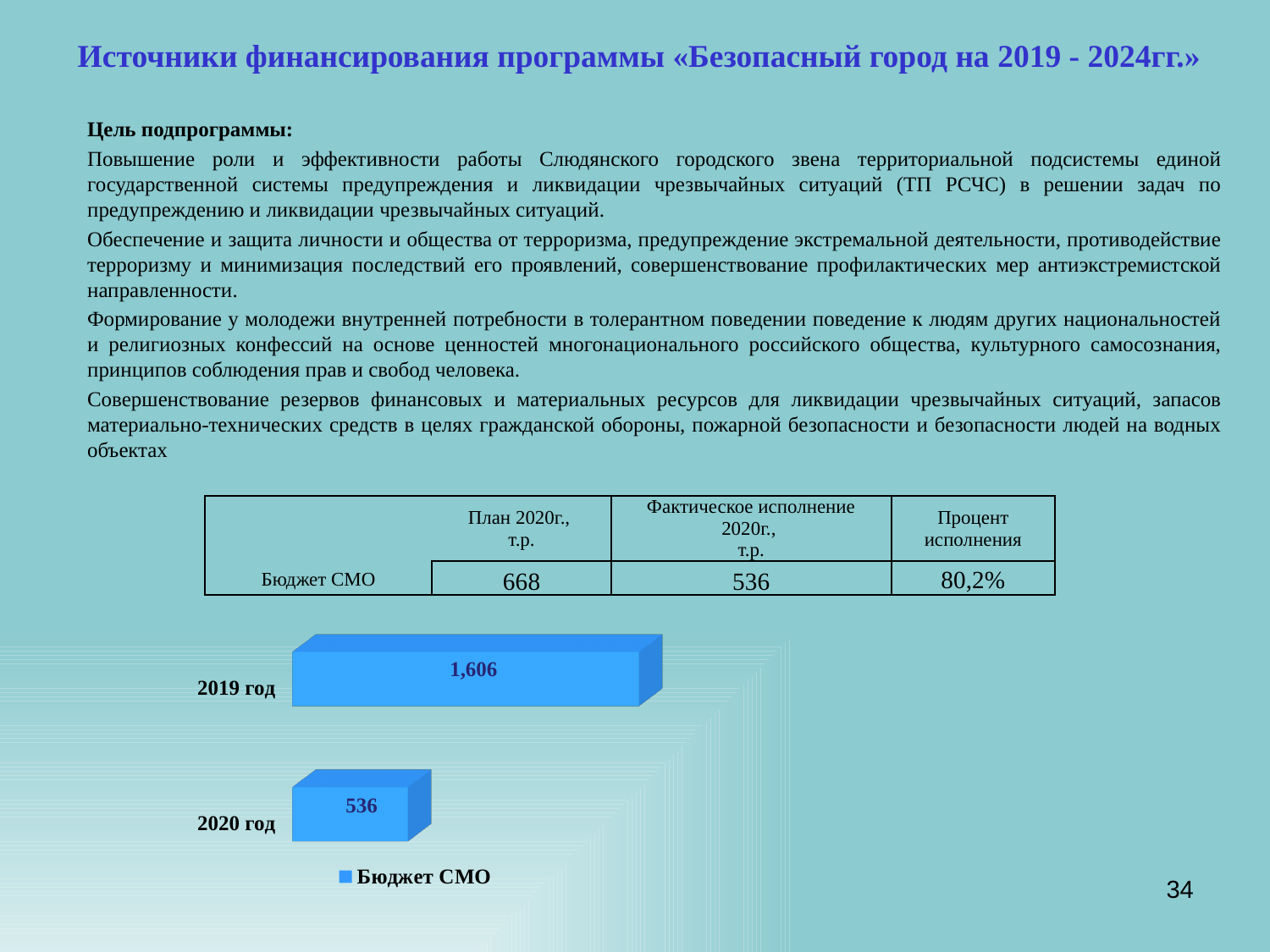
What series name is shown in the chart legend? Бюджет СМО Are the bars in the chart oriented horizontally or vertically? Horizontally What kind of chart is shown on the slide? Bar chart How many series does the chart legend list? 1 What is the value for 2020 год in the chart? 536 Which year has the lowest value in the chart? 2020 год Do the values in the chart rise or fall from 2019 год to 2020 год? Fall What is the difference between the values for 2019 год and 2020 год in the chart? 1,070 How many categories are shown in the chart? 2 Which is larger in the chart: the value for 2019 год or the value for 2020 год? 2019 год Which year has the highest value in the chart? 2019 год What is the value for 2019 год in the chart? 1,606